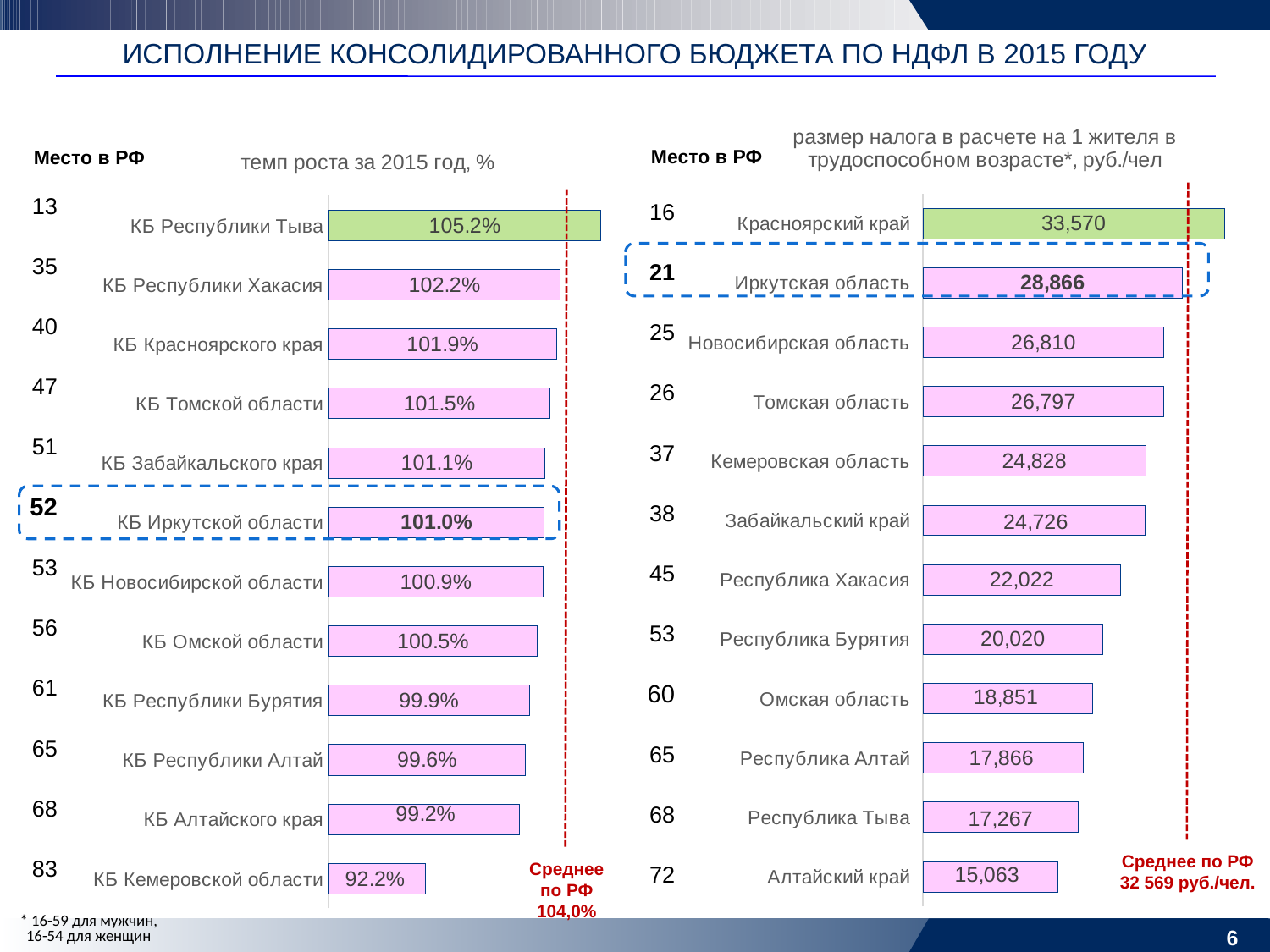
On the right chart (размер налога в расчете на 1 жителя), which is larger: Новосибирская область or Томская область? Новосибирская область On the right chart (размер налога в расчете на 1 жителя), which category has the highest value? Красноярский край On the right chart (размер налога в расчете на 1 жителя), which category has the lowest value? Алтайский край What kind of chart is the right chart (размер налога в расчете на 1 жителя)? bar chart How many categories are shown on the left chart (темп роста за 2015 год, %)? 12 On the left chart (темп роста за 2015 год, %), what is the value for КБ Иркутской области? 101.0% What is the average for the Russian Federation (Среднее по РФ) shown on the right chart? 32 569 руб./чел. On the left chart (темп роста за 2015 год, %), what is the difference between КБ Республики Тыва and КБ Кемеровской области? 13.0% On the left chart (темп роста за 2015 год, %), which category has the lowest value? КБ Кемеровской области On the left chart (темп роста за 2015 год, %), which category has the highest value? КБ Республики Тыва On the right chart (размер налога в расчете на 1 жителя), what is the difference between Красноярский край and Иркутская область? 4,704 On the right chart (размер налога в расчете на 1 жителя), what is the value for Иркутская область? 28,866